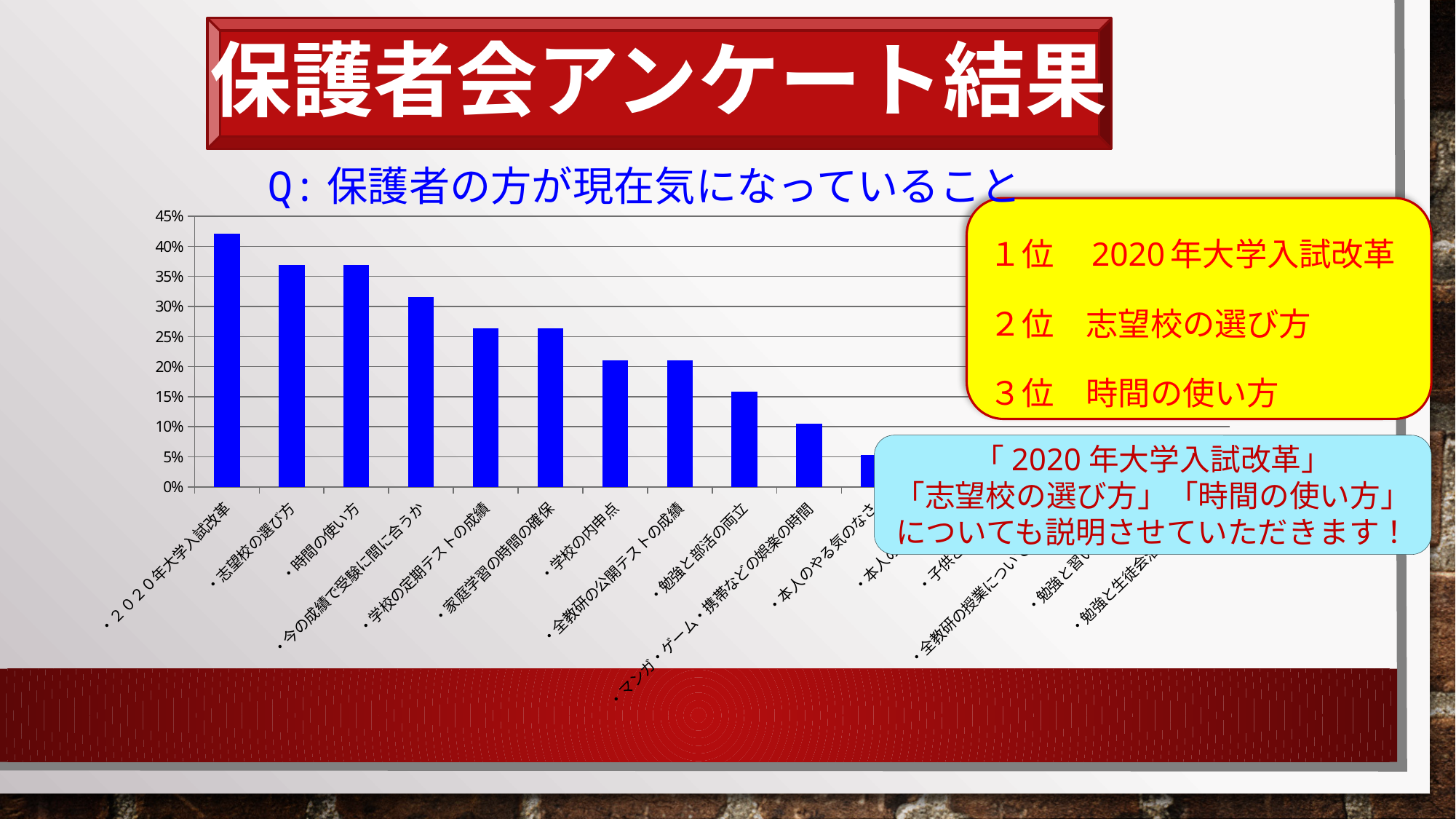
Is the value for 志望校の選び方 greater or less than 35%? greater Is the value for 今の成績で受験に間に合うか greater or less than 30%? greater Which is larger, the value for ２０２０年大学入試改革 or the value for 志望校の選び方? ２０２０年大学入試改革 Is the value for 勉強と部活の両立 greater or less than 20%? less Which category has the highest value in the chart? ２０２０年大学入試改革 Which is larger, the value for 学校の内申点 or the value for 勉強と部活の両立? 学校の内申点 What is the title of the chart? Q：保護者の方が現在気になっていること What kind of chart is shown on the slide? bar chart Do the bar values rise or fall from left to right along the x axis? fall